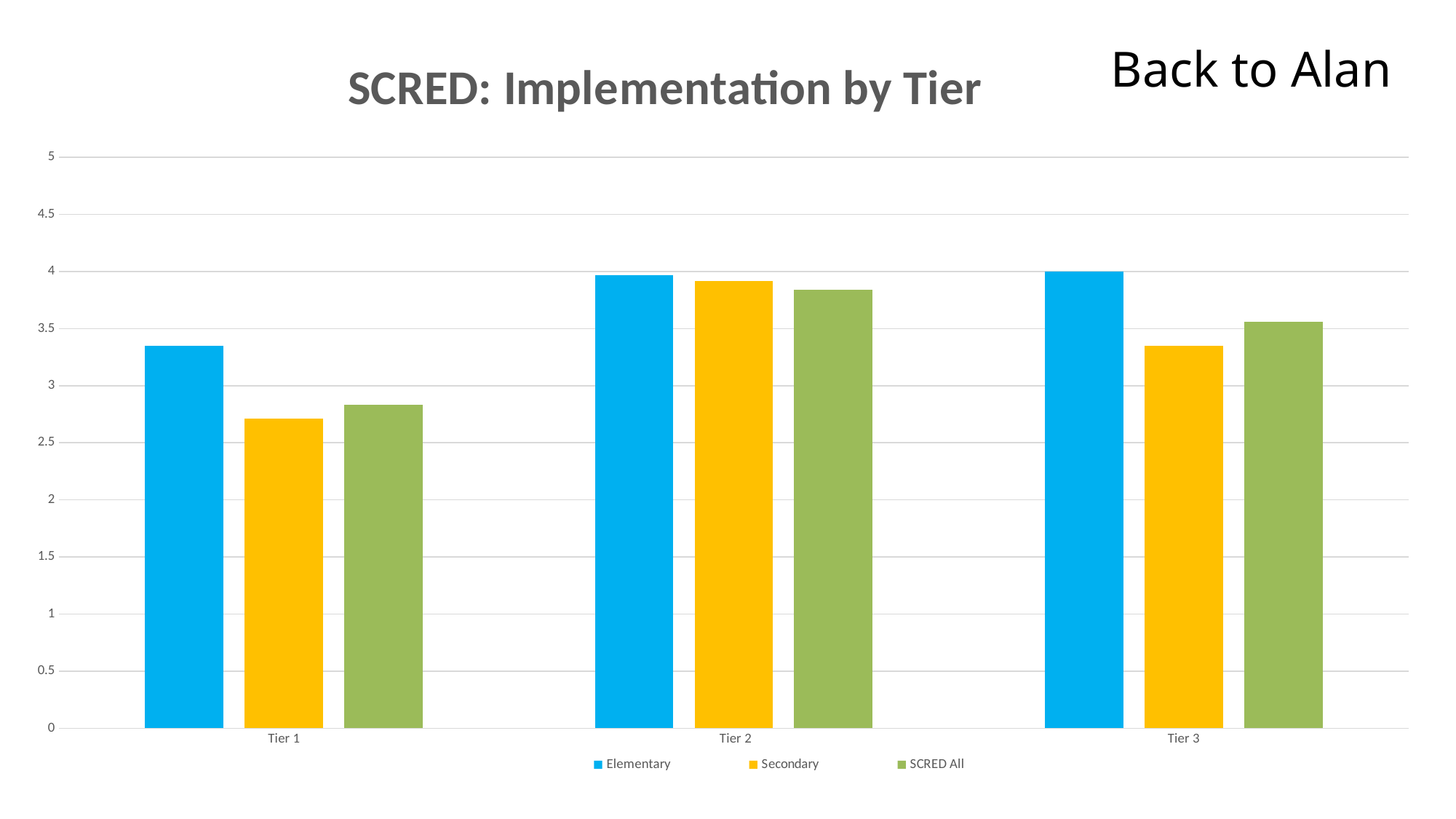
Which tier has the lowest Secondary value? Tier 1 How many series does the legend list? 3 Which tier has the highest SCRED All value? Tier 2 How many tiers are shown on the x axis? 3 Is the SCRED All value for Tier 1 greater or less than 3? less What kind of chart is shown on the slide? Bar chart For Tier 1, which is larger: the Elementary value or the Secondary value? Elementary Is the Elementary value for Tier 2 greater or less than 3.5? greater Is the Secondary value for Tier 1 greater or less than 3? less For Tier 3, which is larger: the Secondary value or the SCRED All value? SCRED All What is the title of the chart? SCRED: Implementation by Tier